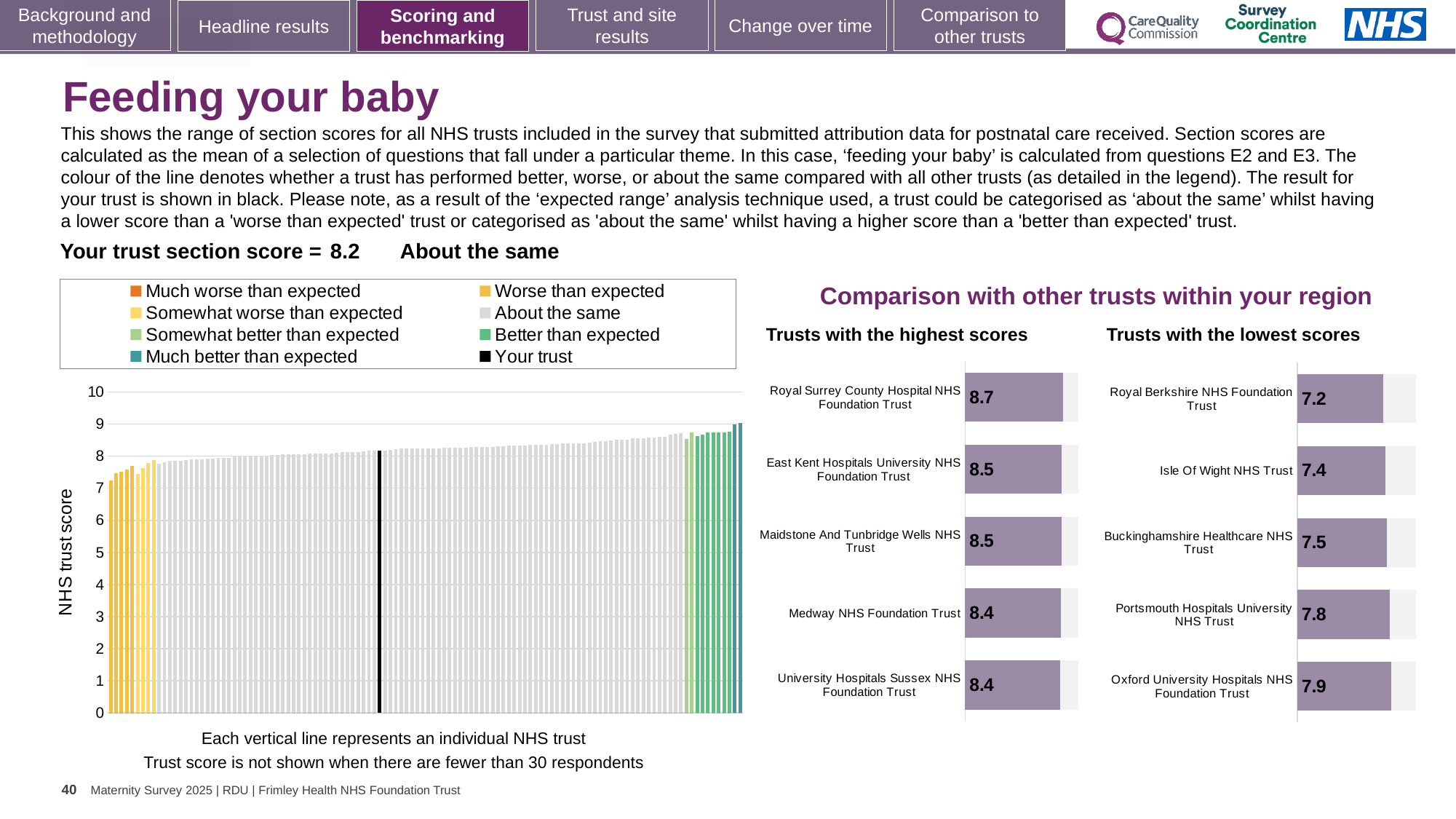
In the 'Trusts with the lowest scores' chart, what is the score for Portsmouth Hospitals University NHS Trust? 7.8 In the 'Trusts with the highest scores' chart, what is the score for Royal Surrey County Hospital NHS Foundation Trust? 8.7 In the 'Trusts with the lowest scores' chart, what is the score for Isle Of Wight NHS Trust? 7.4 In the 'Trusts with the highest scores' chart, what is the difference between the scores of Royal Surrey County Hospital NHS Foundation Trust and Medway NHS Foundation Trust? 0.3 In the 'Trusts with the lowest scores' chart, which trust has the lowest score? Royal Berkshire NHS Foundation Trust What kind of chart is the large 'NHS trust score' chart on the left? Bar chart How many entries does the legend of the large 'NHS trust score' chart list? 8 In the 'Trusts with the lowest scores' chart, which has the larger score: Buckinghamshire Healthcare NHS Trust or Oxford University Hospitals NHS Foundation Trust? Oxford University Hospitals NHS Foundation Trust In the 'Trusts with the highest scores' chart, which trust has the highest score? Royal Surrey County Hospital NHS Foundation Trust In the large 'NHS trust score' chart on the left, do the values rise or fall from left to right? Rise In the large 'NHS trust score' chart on the left, is the value of the leftmost bar greater or less than 8? less How many trusts are shown in the 'Trusts with the lowest scores' chart? 5